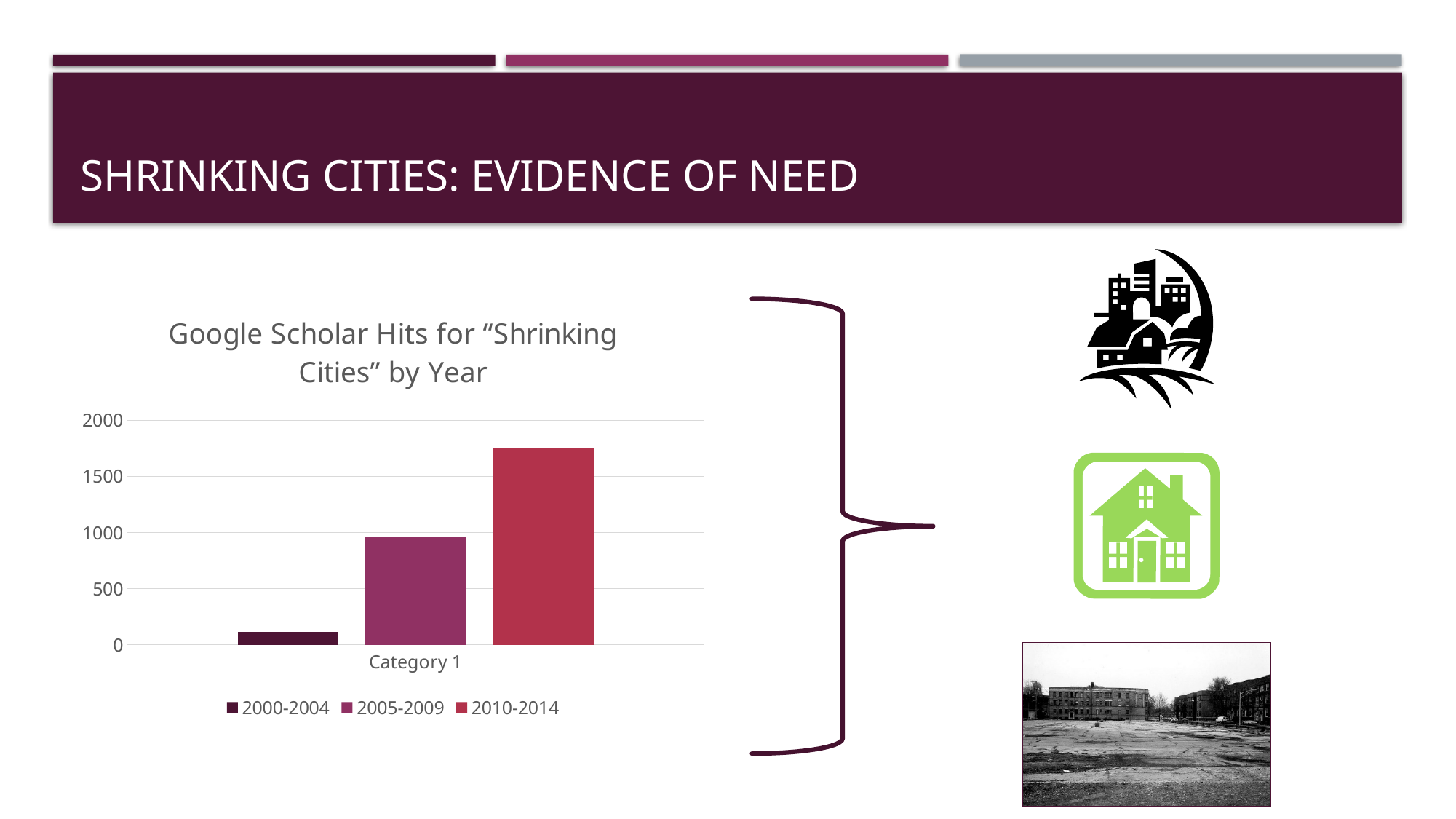
Which is larger, the value for 2005-2009 or the value for 2010-2014? 2010-2014 Is the value for 2000-2004 greater or less than 500? less Which series has the highest bar in the chart? 2010-2014 What kind of chart is shown on the slide? bar chart Is the value for 2005-2009 greater or less than 500? greater How many series does the chart's legend list? 3 What is the title of the chart? Google Scholar Hits for "Shrinking Cities" by Year Which series has the lowest bar in the chart? 2000-2004 Do the bars rise or fall from the 2000-2004 series to the 2010-2014 series? rise How many categories are shown on the x axis of the chart? 1 Is the value for 2010-2014 greater or less than 1500? greater What is the label of the single category on the x axis? Category 1